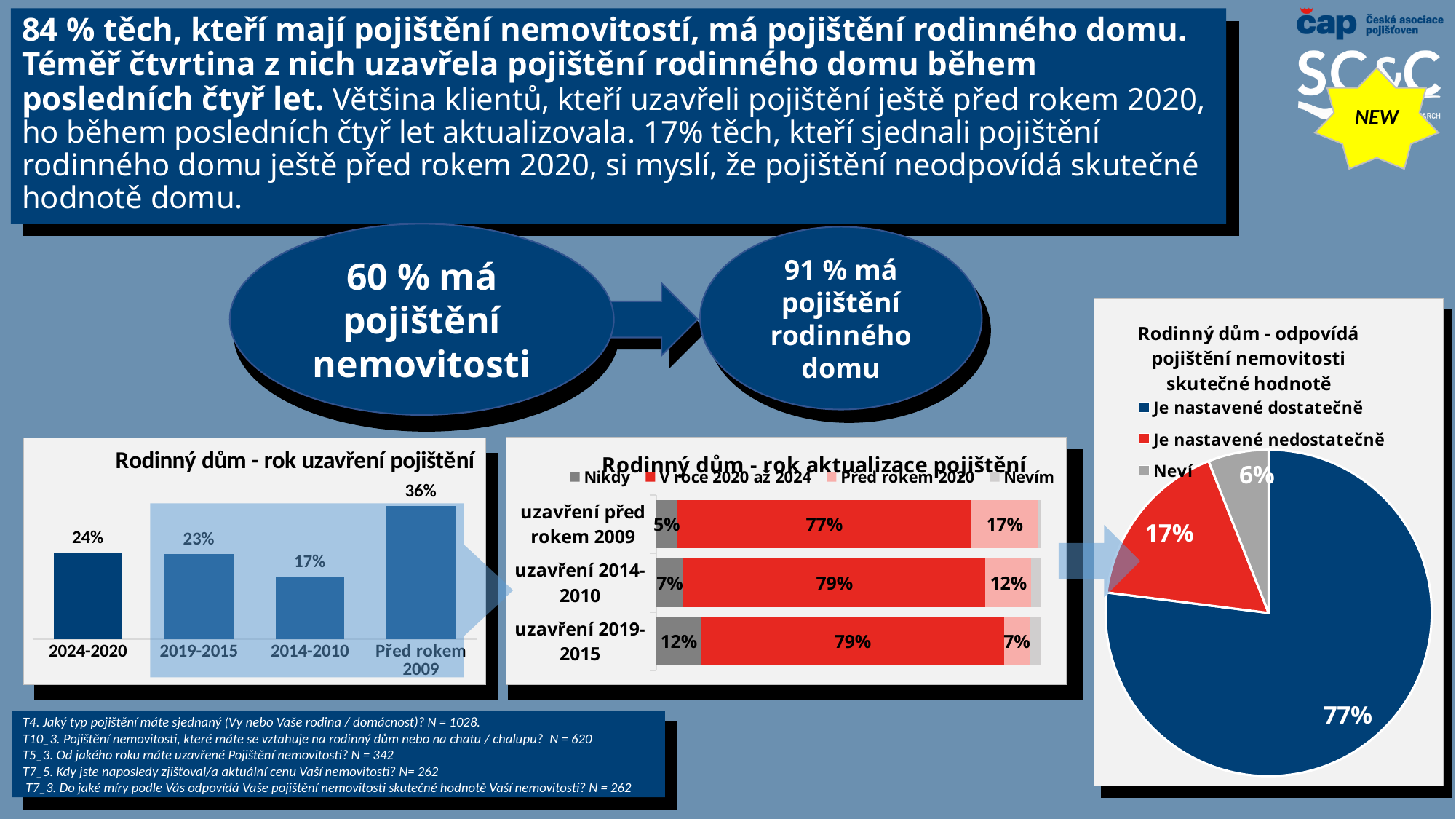
In the chart 'Rodinný dům - rok aktualizace pojištění', what is the value of 'Nikdy' for 'uzavření 2019-2015'? 12% How many series does the legend of the chart 'Rodinný dům - rok aktualizace pojištění' list? 4 How many categories are shown in the chart 'Rodinný dům - rok uzavření pojištění'? 4 In the chart 'Rodinný dům - rok uzavření pojištění', what is the value for 'Před rokem 2009'? 36% In the pie chart 'Rodinný dům - odpovídá pojištění nemovitosti skutečné hodnotě', what share is 'Je nastavené nedostatečně'? 17% What type of chart is 'Rodinný dům - rok uzavření pojištění'? bar chart In the pie chart 'Rodinný dům - odpovídá pojištění nemovitosti skutečné hodnotě', which slice is the largest? Je nastavené dostatečně In the chart 'Rodinný dům - rok aktualizace pojištění', which is larger: the 'Před rokem 2020' value for 'uzavření před rokem 2009' or for 'uzavření 2019-2015'? uzavření před rokem 2009 In the chart 'Rodinný dům - rok uzavření pojištění', what is the difference between the values for '2024-2020' and '2014-2010'? 7% In the chart 'Rodinný dům - rok aktualizace pojištění', what is the value of 'V roce 2020 až 2024' for 'uzavření před rokem 2009'? 77% In the chart 'Rodinný dům - rok uzavření pojištění', which category has the lowest value? 2014-2010 In the chart 'Rodinný dům - rok uzavření pojištění', which category has the highest value? Před rokem 2009